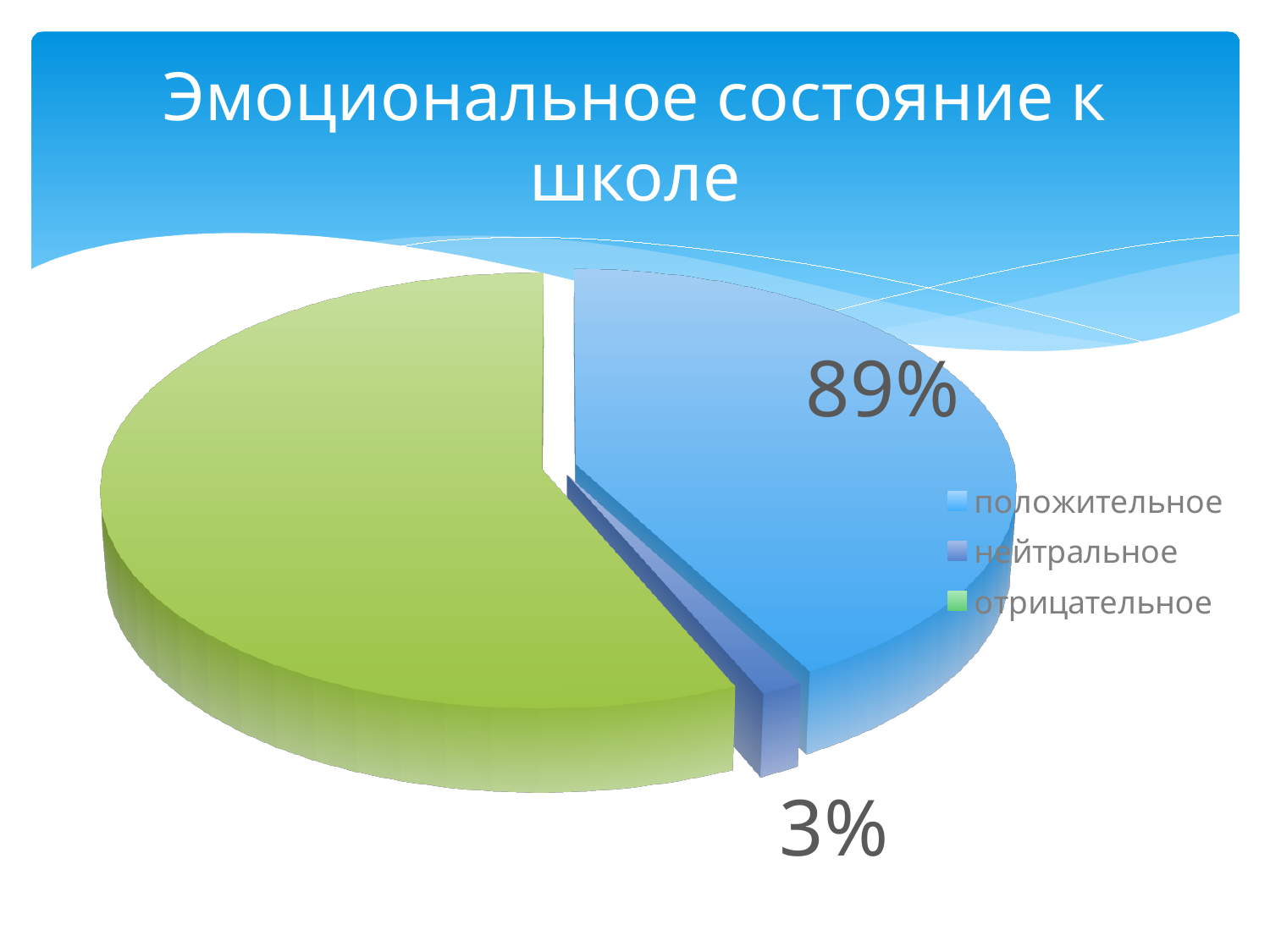
Is the labelled value for положительное greater or less than 50%? greater Which colour represents отрицательное in the legend? green Which has the larger labelled value, положительное or нейтральное? положительное How many categories does the legend list? 3 What percentage is labelled for the положительное slice? 89% What is the difference between the labelled values for положительное and нейтральное? 86% What is the title of the chart? Эмоциональное состояние к школе What kind of chart is shown on the slide? pie chart What percentage is labelled for the нейтральное slice? 3% Is the labelled value for нейтральное greater or less than 10%? less